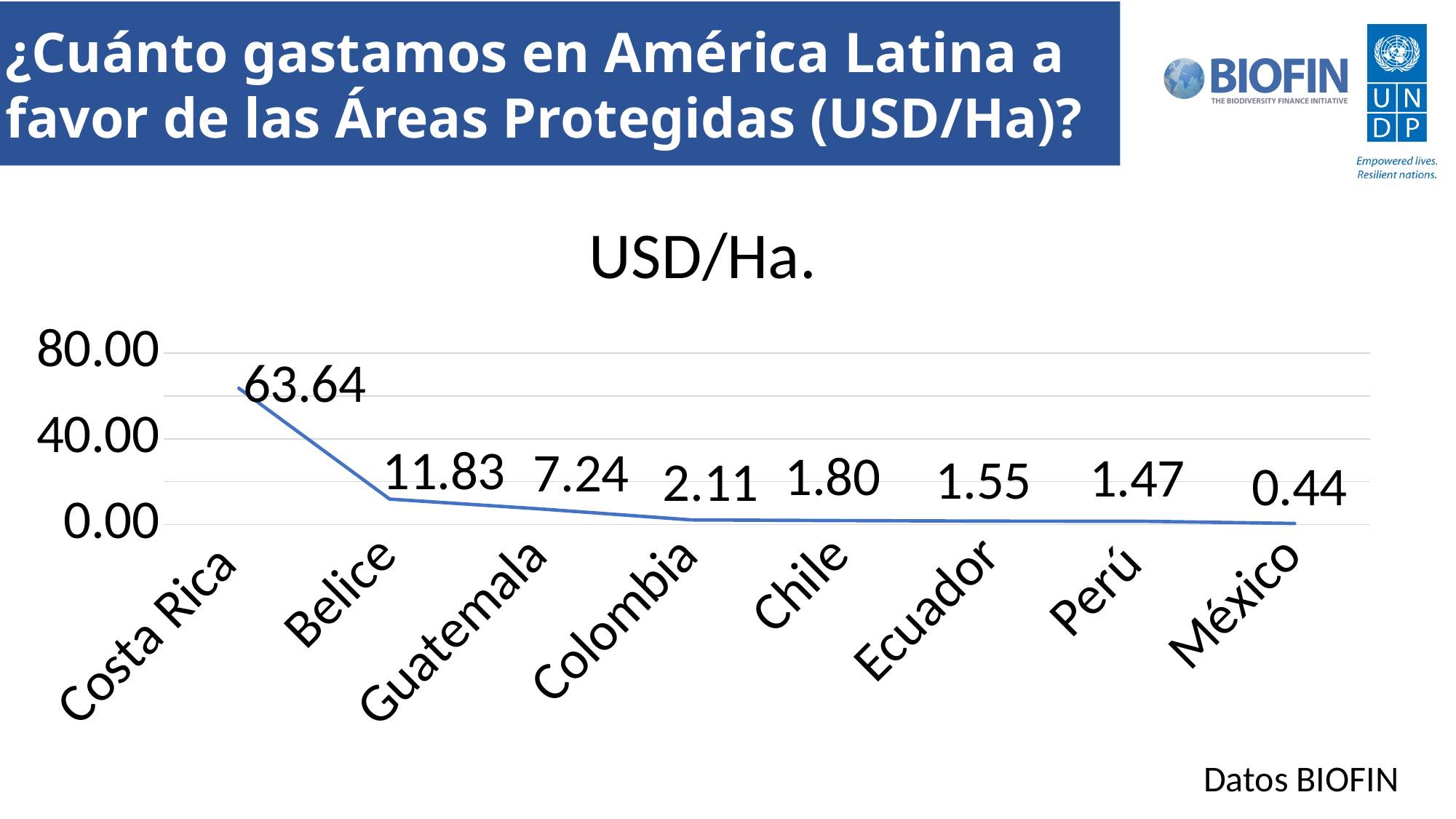
Is the value for Costa Rica greater or less than 40.00? greater What is the value for Belice? 11.83 Which country has the lowest value? México What is the value for Costa Rica? 63.64 Which country has the highest value? Costa Rica Which has a larger value, Colombia or Chile? Colombia What is the value for Guatemala? 7.24 What is the value for México? 0.44 How many countries are plotted on the chart? 8 What is the difference between the values for Costa Rica and Belice? 51.81 What kind of chart is shown? line chart Do the values rise or fall from Costa Rica to México along the x axis? fall